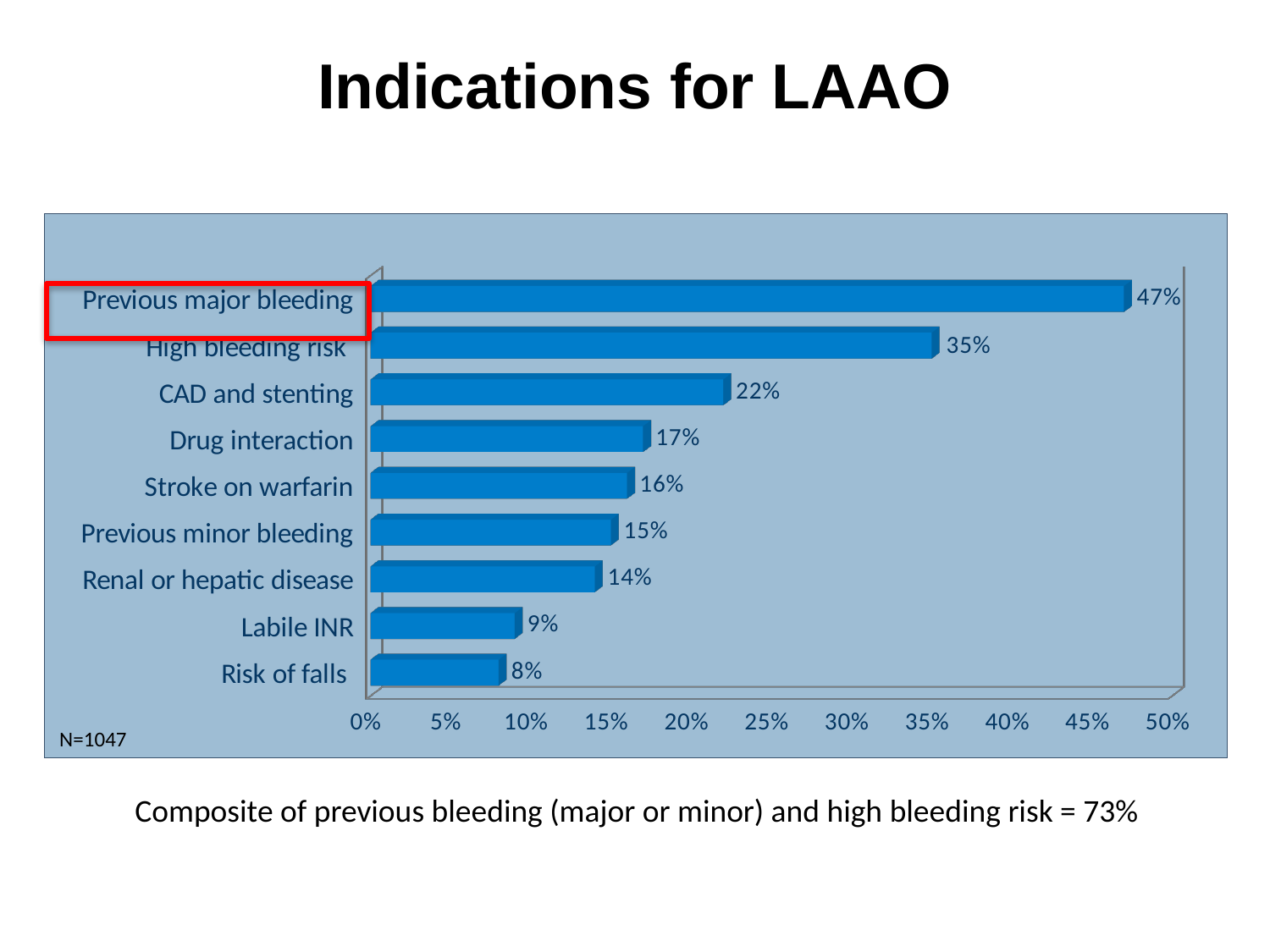
What is the value for CAD and stenting? 22% What sample size (N) is noted on the chart? N=1047 Is the value for High bleeding risk greater or less than 30%? greater What is the difference between the values for Previous major bleeding and High bleeding risk? 12% Which indication has the lowest value? Risk of falls Which indication has the highest value? Previous major bleeding What is the value for Previous major bleeding? 47% What kind of chart is shown on the slide? bar chart How many indications are shown in the chart? 9 What is the value for Labile INR? 9% What is the difference between the values for Drug interaction and Renal or hepatic disease? 3% Which is larger, the value for Stroke on warfarin or the value for Labile INR? Stroke on warfarin